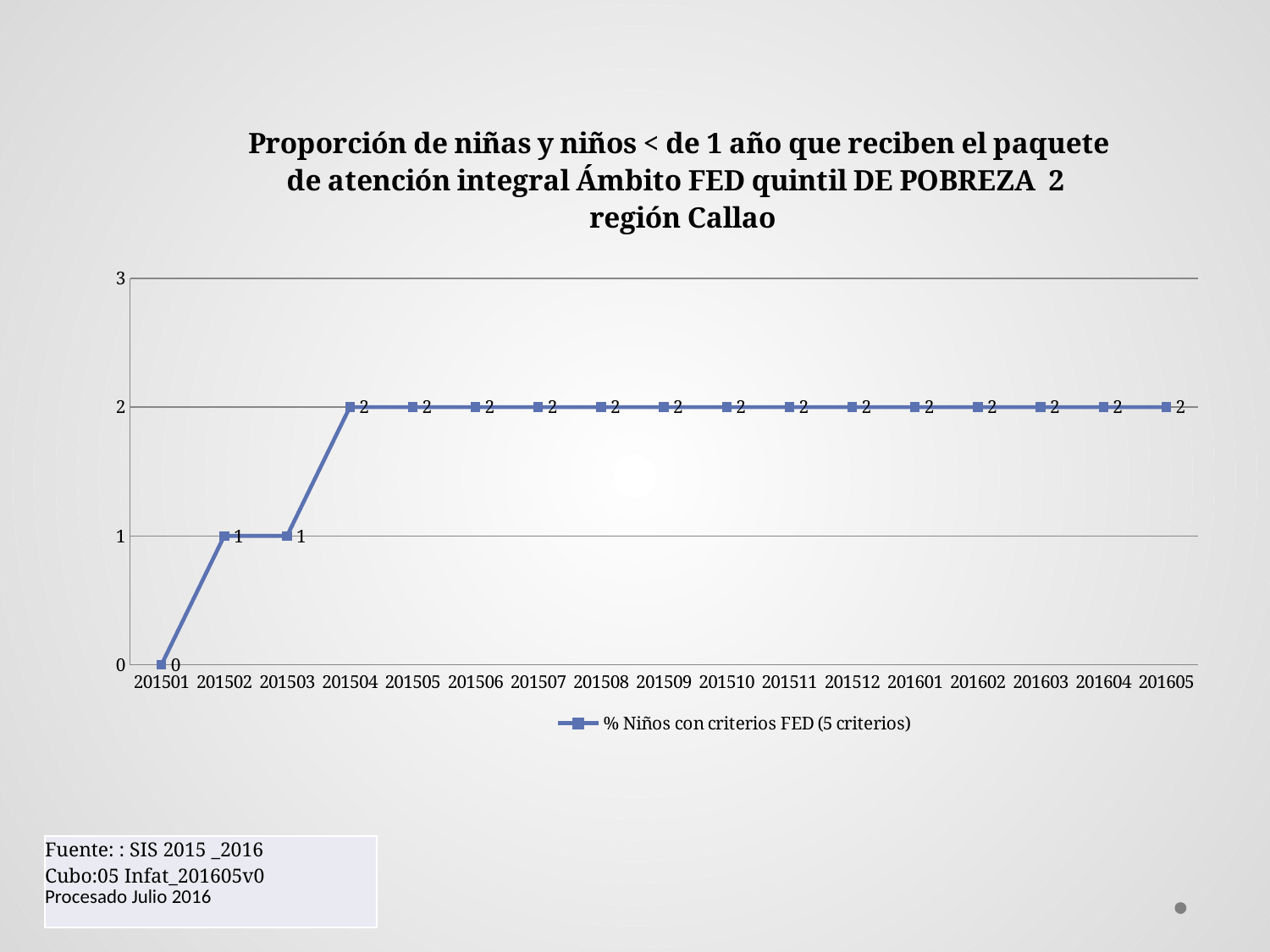
What is the name of the series shown in the legend? % Niños con criterios FED (5 criterios) Do the values rise or fall from 201501 to 201504? rise What is the value for 201605? 2 What is the value for 201502? 1 How many series does the legend list? 1 Which period has the lowest value? 201501 How many periods are plotted on the x axis? 17 Which is larger, the value for 201502 or the value for 201505? 201505 What is the value for 201504? 2 What type of chart is shown on the slide? line chart What is the difference between the values for 201504 and 201503? 1 What is the value for 201501? 0